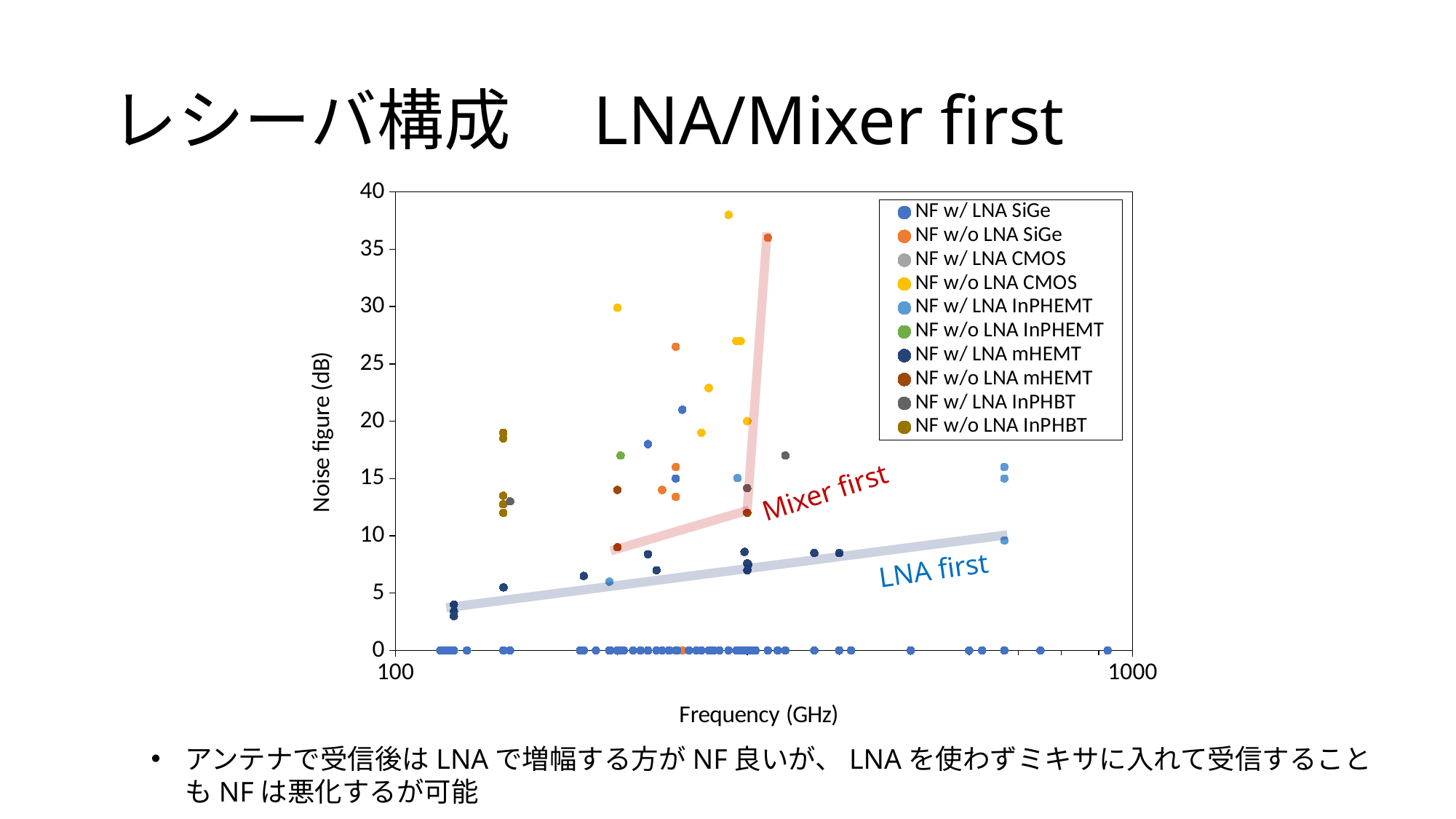
Does the 'LNA first' trend line rise or fall as frequency increases? rise Which series has the single highest plotted point on the chart? NF w/o LNA CMOS Is the highest plotted value for NF w/ LNA mHEMT greater or less than 10? less What is the label of the x axis of the chart? Frequency (GHz) What kind of chart is shown on the slide? scatter chart Is the highest plotted value for NF w/ LNA InPHEMT greater or less than 10? greater Is the highest plotted value for NF w/o LNA SiGe greater or less than 30? greater How many series does the chart legend list? 10 What is the label of the y axis of the chart? Noise figure (dB)